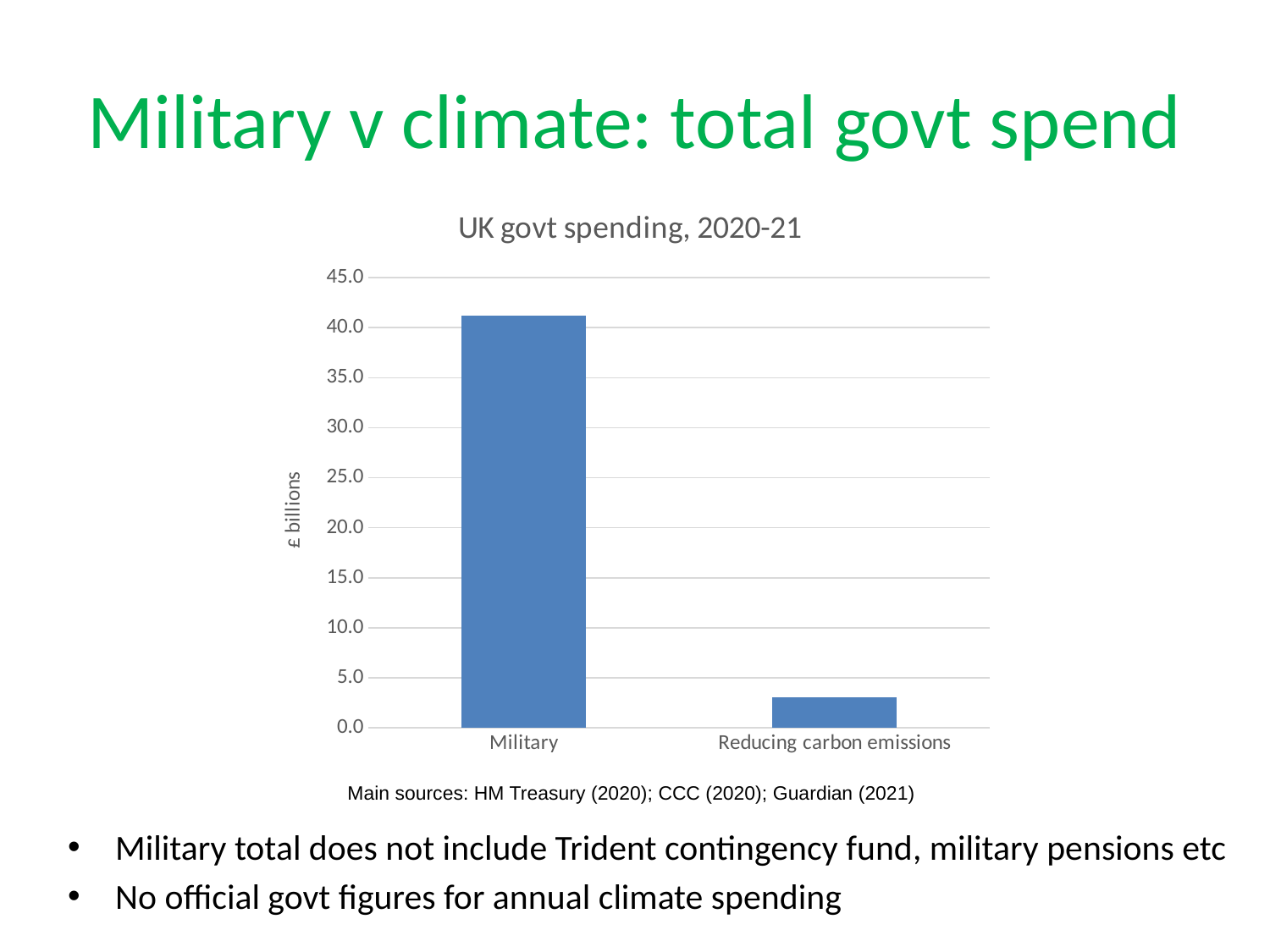
Which is larger, the value for Military or the value for Reducing carbon emissions? Military What kind of chart is shown on the slide? bar chart How many categories are plotted in the chart? 2 Is the value for Reducing carbon emissions greater or less than 10.0? less Do the values rise or fall from left to right across the categories? fall Which category has the highest value in the chart? Military Is the value for Reducing carbon emissions greater or less than 5.0? less What is the label on the vertical axis of the chart? £ billions What is the title of the chart? UK govt spending, 2020-21 Which category has the lowest value in the chart? Reducing carbon emissions Is the value for Military greater or less than 30.0? greater